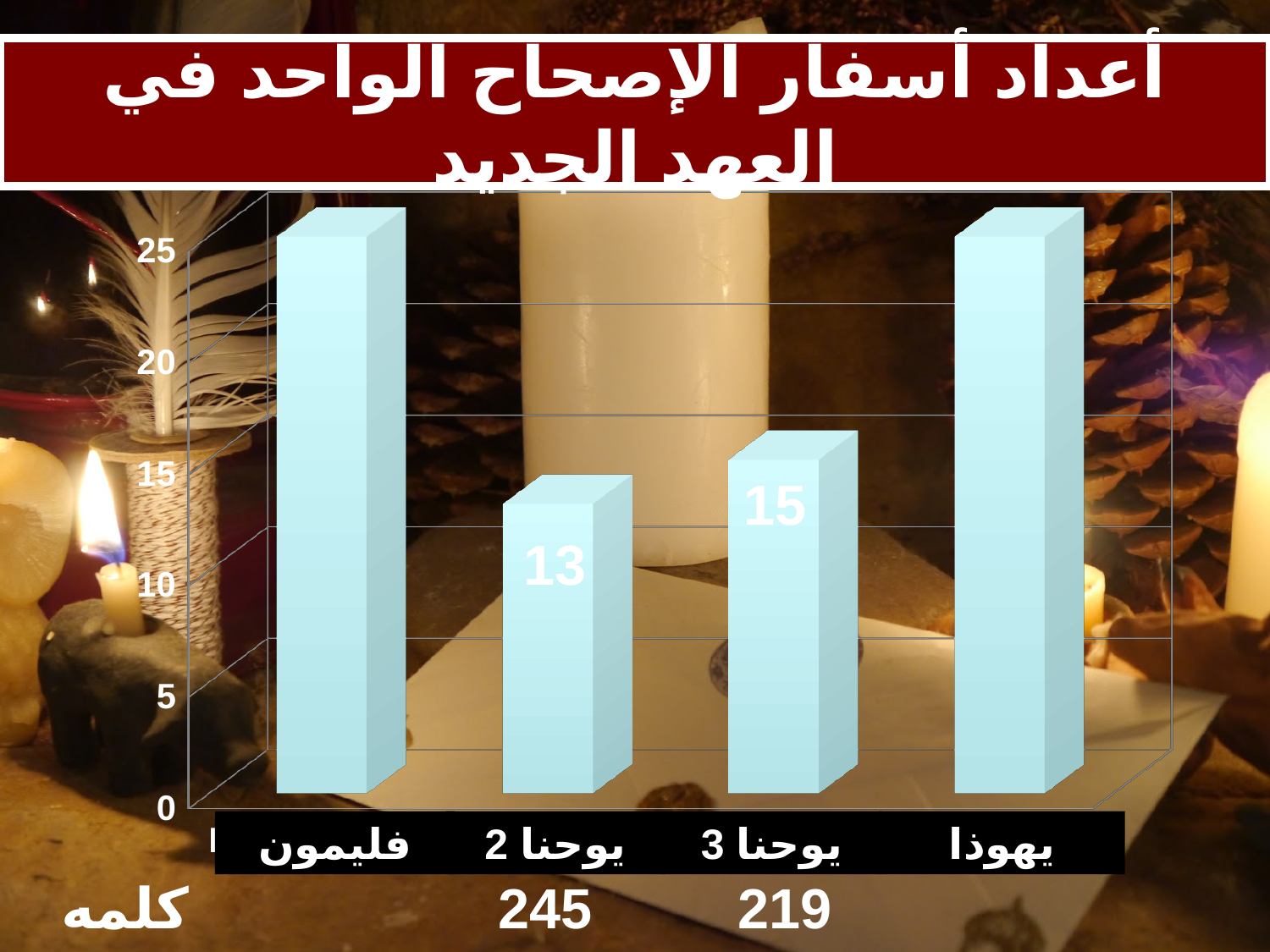
What is the value for يوحنا 2? 13 What colour are the bars in the chart? light blue Is the value for يهوذا greater or less than 20? greater How many categories are shown on the x axis? 4 What kind of chart is shown on the slide? bar chart What is the title of the slide? أعداد أسفار الإصحاح الواحد في العهد الجديد Is the value for يوحنا 2 greater or less than 15? less Which has the larger value, يوحنا 2 or يوحنا 3? يوحنا 3 Is the value for فليمون greater or less than 20? greater What is the difference between the values for يوحنا 3 and يوحنا 2? 2 Which category has the lowest value? يوحنا 2 What is the value for يوحنا 3? 15